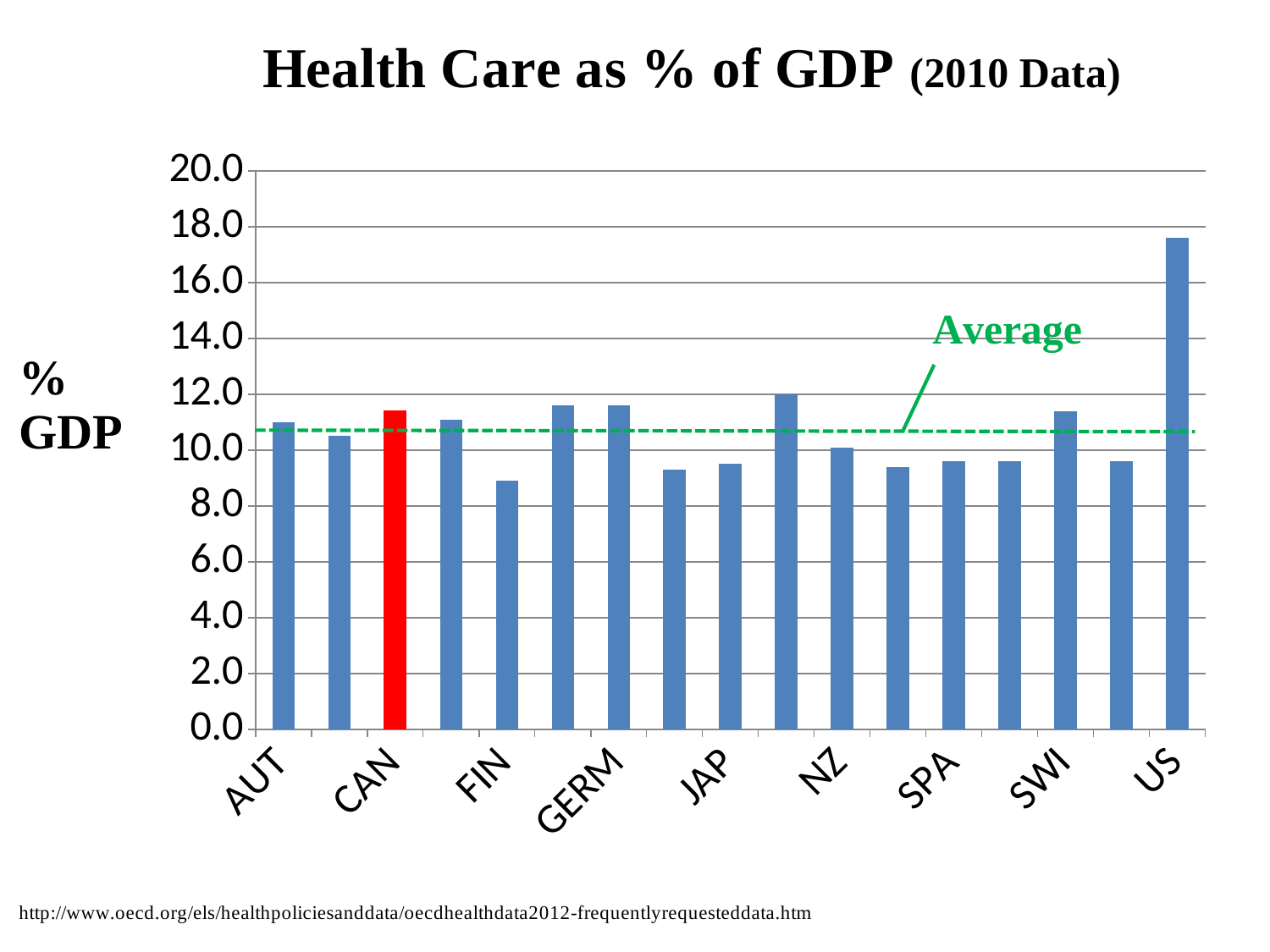
Which country's bar is coloured red? CAN Is the value for CAN greater or less than 10.0? greater Which is larger, the value for US or the value for CAN? US Which country has the highest health care spending as % of GDP? US How many country labels are shown on the x axis? 9 Which is larger, the value for GERM or the value for FIN? GERM Is the value for JAP greater or less than 10.0? less What kind of chart is shown on the slide? bar chart Which labeled country has the lowest health care spending as % of GDP? FIN Is the value for FIN greater or less than 10.0? less What does the green dashed line represent? Average